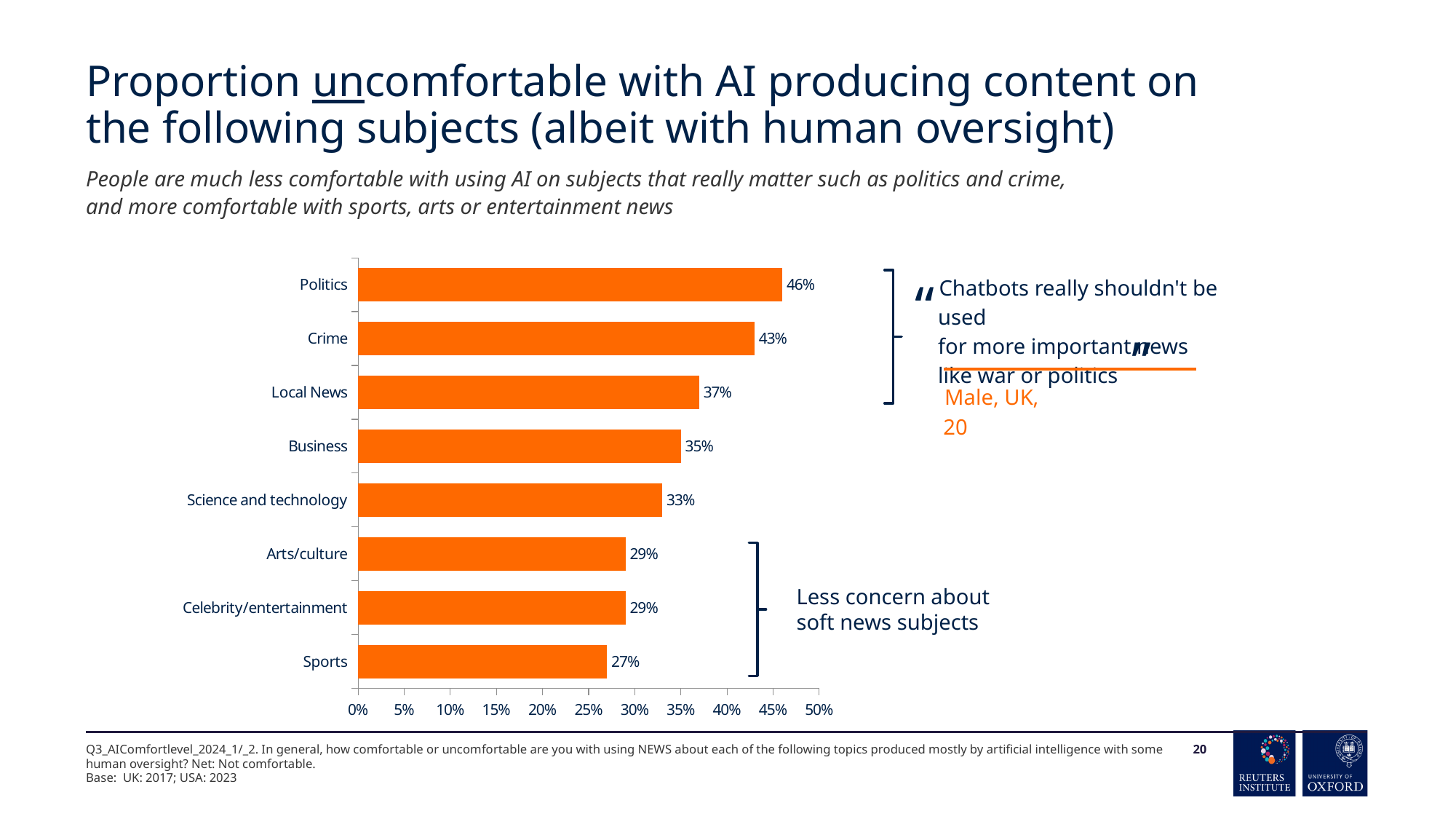
Is the value for Local News greater or less than 40%? less Which subject has the highest proportion uncomfortable? Politics What is the maximum value shown on the percentage axis? 50% What is the difference between the values for Politics and Sports? 19% Which subject has the lowest proportion uncomfortable? Sports What is the difference between the values for Crime and Business? 8% What is the value shown for Science and technology? 33% What kind of chart is shown on the slide? Bar chart What proportion is uncomfortable with AI producing content on Politics? 46% How many subjects are shown in the chart? 8 Which is larger, the value for Crime or the value for Business? Crime What is the value shown for Local News? 37%